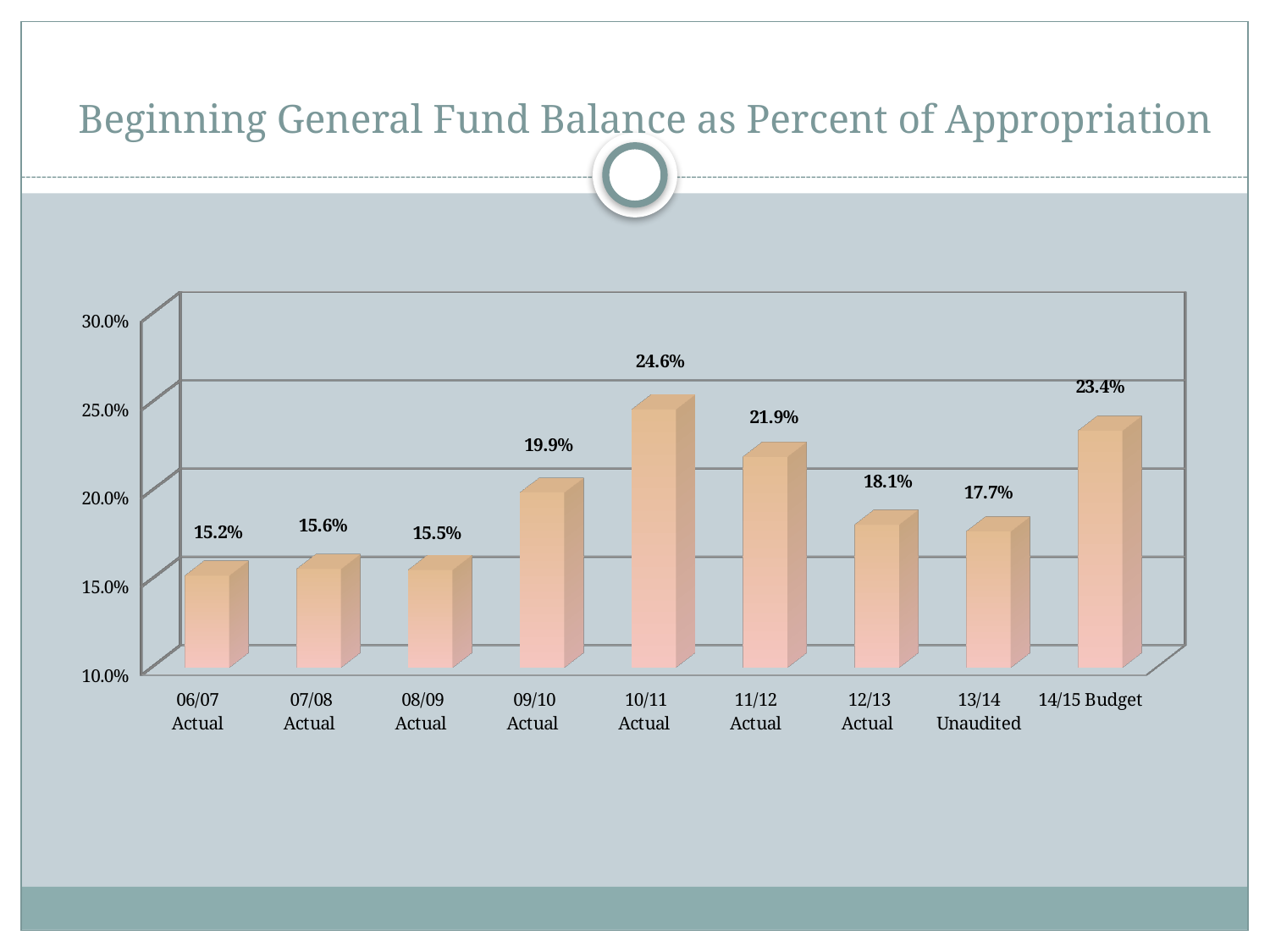
What is the title of the chart? Beginning General Fund Balance as Percent of Appropriation How many categories are shown on the x axis? 9 What kind of chart is shown on the slide? bar chart What is the value for 10/11 Actual? 24.6% What is the value for 14/15 Budget? 23.4% What is the difference between the values for 10/11 Actual and 11/12 Actual? 2.7% Is the value for 11/12 Actual greater or less than 20.0%? greater Which category has the highest value? 10/11 Actual Which category has the lowest value? 06/07 Actual What is the value for 13/14 Unaudited? 17.7% Which is larger, the value for 09/10 Actual or the value for 12/13 Actual? 09/10 Actual Do the values rise or fall from 06/07 Actual to 10/11 Actual? rise